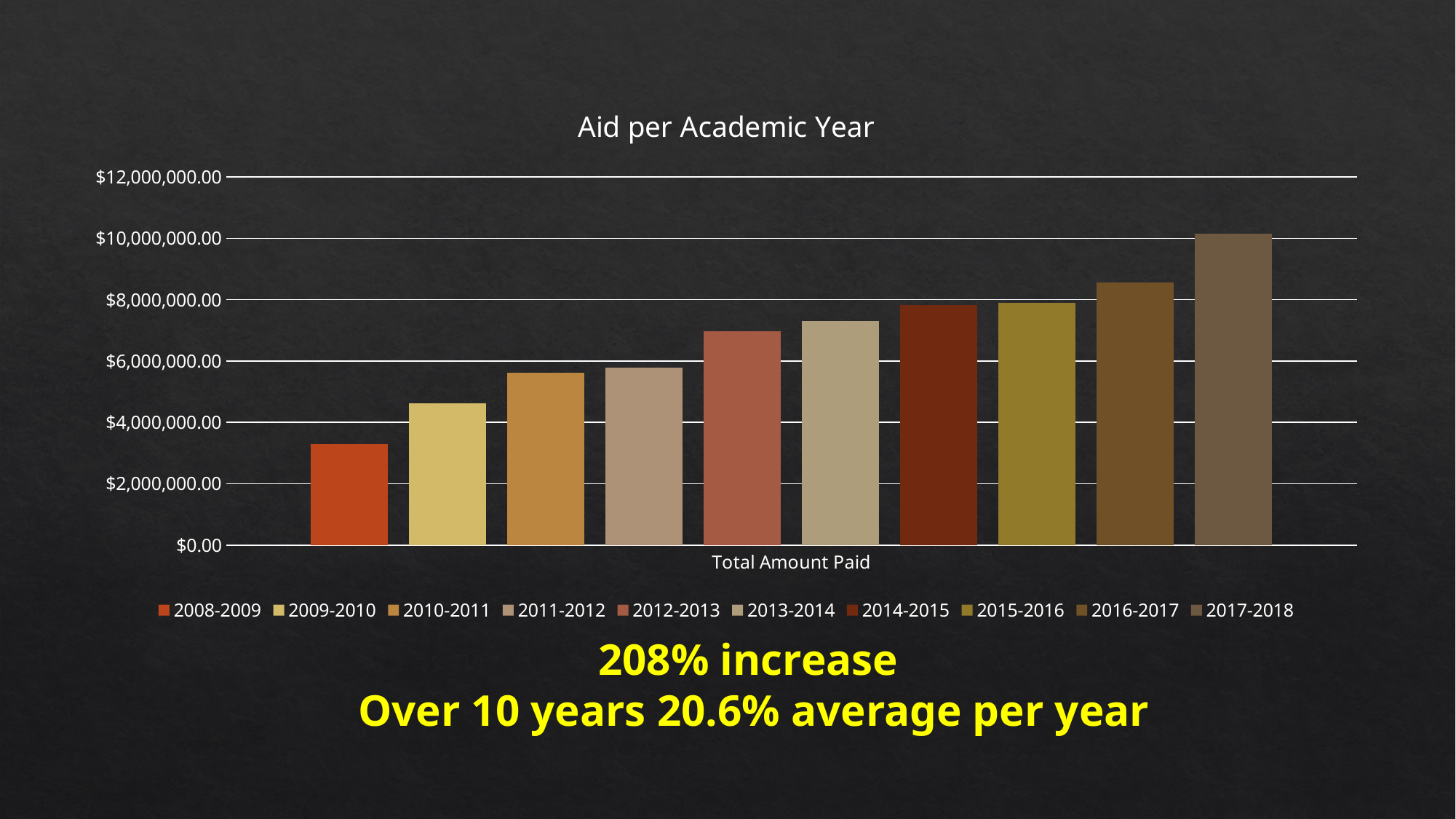
Which is larger, the value for 2016-2017 or the value for 2012-2013? 2016-2017 Is the value for 2017-2018 greater or less than $8,000,000.00? greater What is the title of the chart? Aid per Academic Year Is the value for 2016-2017 greater or less than $8,000,000.00? greater Is the value for 2012-2013 greater or less than $6,000,000.00? greater What type of chart is shown on the slide? bar chart Which academic year has the lowest bar? 2008-2009 How many series does the legend list? 10 Do the bar values rise or fall from 2008-2009 to 2017-2018? rise Which academic year has the highest bar? 2017-2018